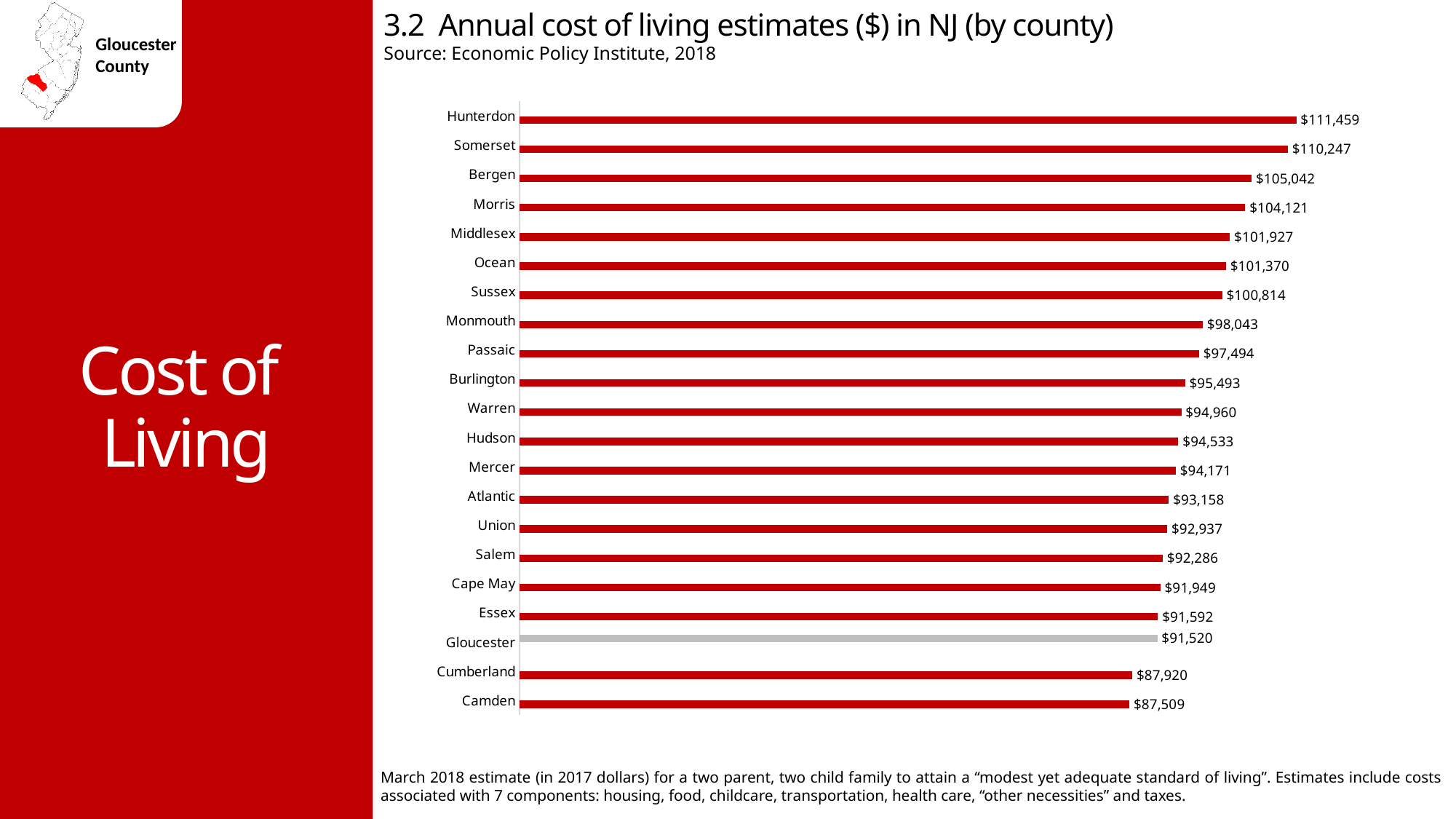
What is the annual cost of living estimate for Bergen County? $105,042 What is the annual cost of living estimate for Monmouth County? $98,043 Which county has the highest annual cost of living estimate? Hunterdon Which county has a higher cost of living estimate, Ocean or Passaic? Ocean What is the annual cost of living estimate for Gloucester County? $91,520 How many counties are shown in the chart? 21 Which county has the lowest annual cost of living estimate? Camden How much higher is Gloucester County's cost of living estimate than Camden County's? $4,011 What type of chart is used to show the annual cost of living estimates? Bar chart What is the difference between the cost of living estimates for Hunterdon and Camden counties? $23,950 Which county's bar is shown in grey rather than red? Gloucester What is the source cited for the chart? Economic Policy Institute, 2018